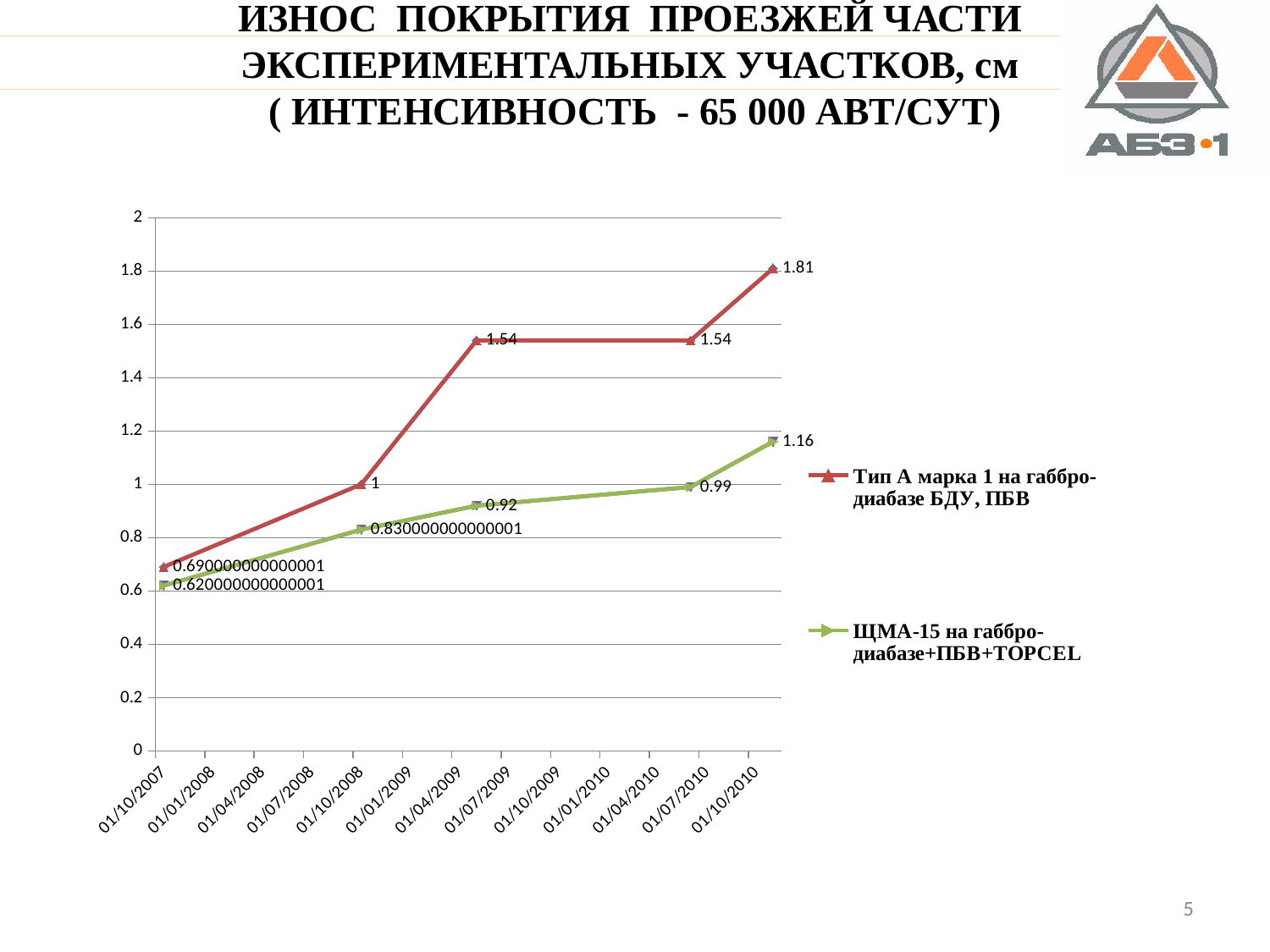
How many series does the legend list? 2 What is the difference between the two series at 01/10/2010? 0.65 How many data points are plotted for the series 'Тип А марка 1 на габбро-диабазе БДУ, ПБВ'? 5 What is the value for the series 'ЩМА-15 на габбро-диабазе+ПБВ+TOPCEL' at 01/07/2010? 0.99 Which series has the higher value at 01/10/2010? Тип А марка 1 на габбро-диабазе БДУ, ПБВ What is the value for the series 'Тип А марка 1 на габбро-диабазе БДУ, ПБВ' at 01/10/2010? 1.81 Do the values of the series 'ЩМА-15 на габбро-диабазе+ПБВ+TOPCEL' rise or fall along the x axis? rise What is the highest value reached by the series 'Тип А марка 1 на габбро-диабазе БДУ, ПБВ'? 1.81 What kind of chart is shown on the slide? line chart What is the value for the series 'ЩМА-15 на габбро-диабазе+ПБВ+TOPCEL' at 01/10/2010? 1.16 What is the value for the series 'Тип А марка 1 на габбро-диабазе БДУ, ПБВ' at 01/10/2008? 1 What is the value for the series 'ЩМА-15 на габбро-диабазе+ПБВ+TOPCEL' at 01/10/2007? 0.620000000000001